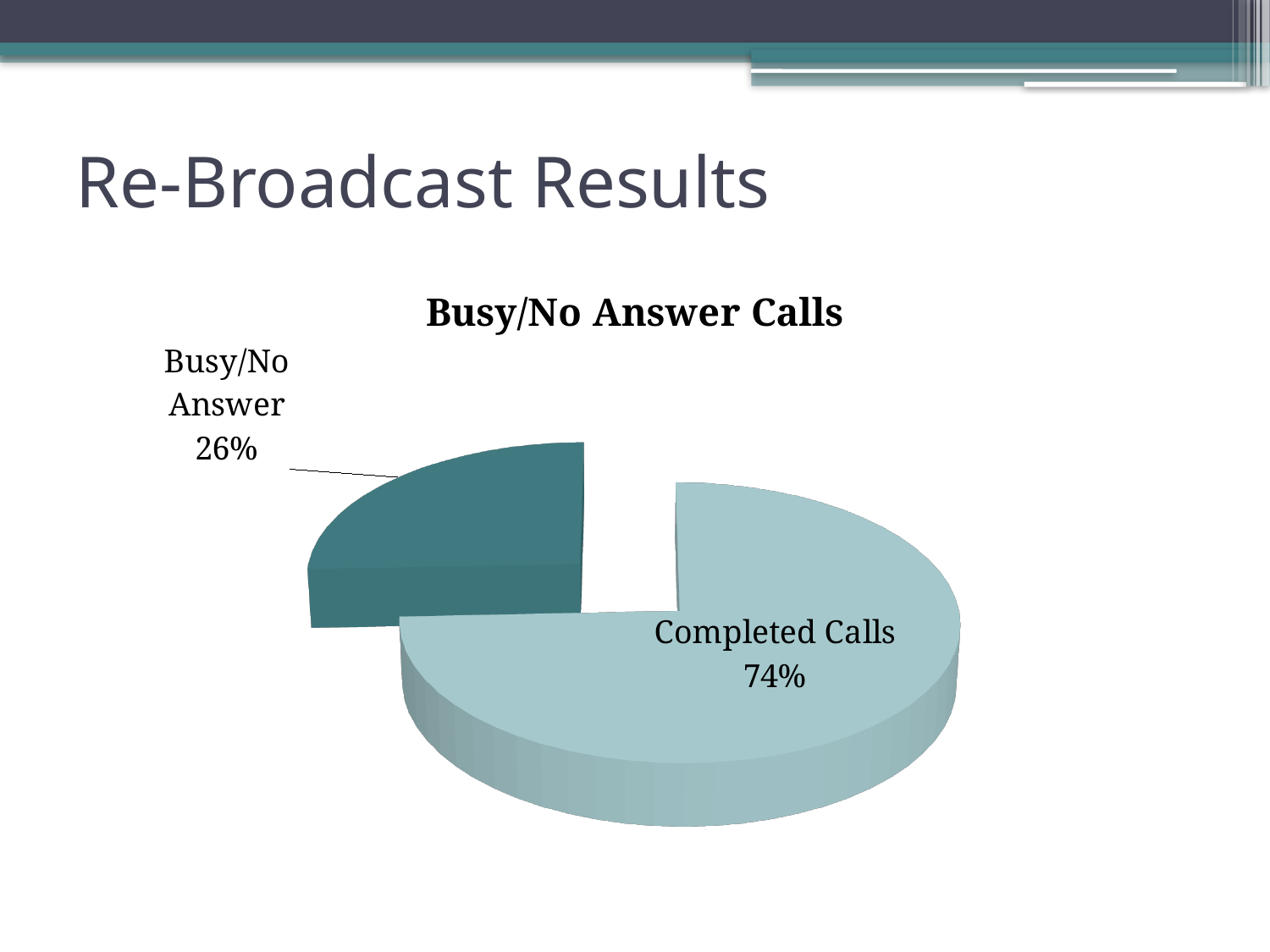
What is the difference in percentage points between Completed Calls and Busy/No Answer? 48 Is the share for Completed Calls greater or less than 50%? greater What percentage of calls were Completed Calls? 74% Which is larger, the share for Completed Calls or the share for Busy/No Answer? Completed Calls Which slice of the pie is the smallest? Busy/No Answer What type of chart is shown on the slide? pie chart Which slice is shown in the darker teal colour? Busy/No Answer What share of the pie does the Busy/No Answer slice represent? 26% What is the title of the chart? Busy/No Answer Calls What percentage of calls were Busy/No Answer? 26% How many slices does the pie chart have? 2 Which slice of the pie is the largest? Completed Calls